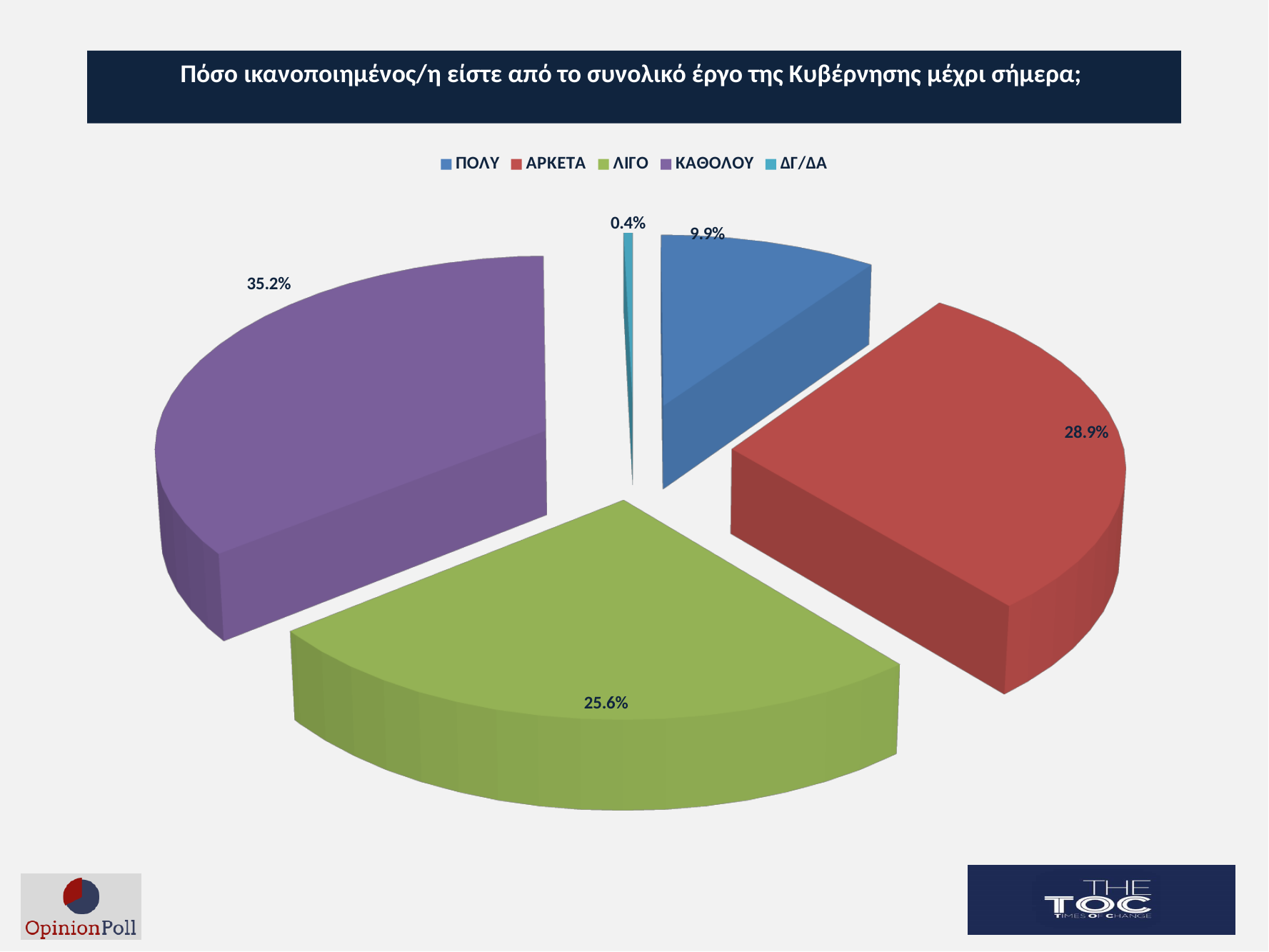
What is the difference between the values for ΚΑΘΟΛΟΥ and ΑΡΚΕΤΑ? 6.3% What is the value for ΚΑΘΟΛΟΥ? 35.2% What kind of chart is shown on the slide? pie chart Which category has the largest share of the pie? ΚΑΘΟΛΟΥ Which category has the smallest share of the pie? ΔΓ/ΔΑ How many categories does the legend list? 5 What is the value for ΛΙΓΟ? 25.6% What colour is the slice for ΛΙΓΟ? green What is the value for ΑΡΚΕΤΑ? 28.9% Which is larger, the value for ΑΡΚΕΤΑ or the value for ΛΙΓΟ? ΑΡΚΕΤΑ What is the value for ΔΓ/ΔΑ? 0.4% What is the value for ΠΟΛΥ? 9.9%